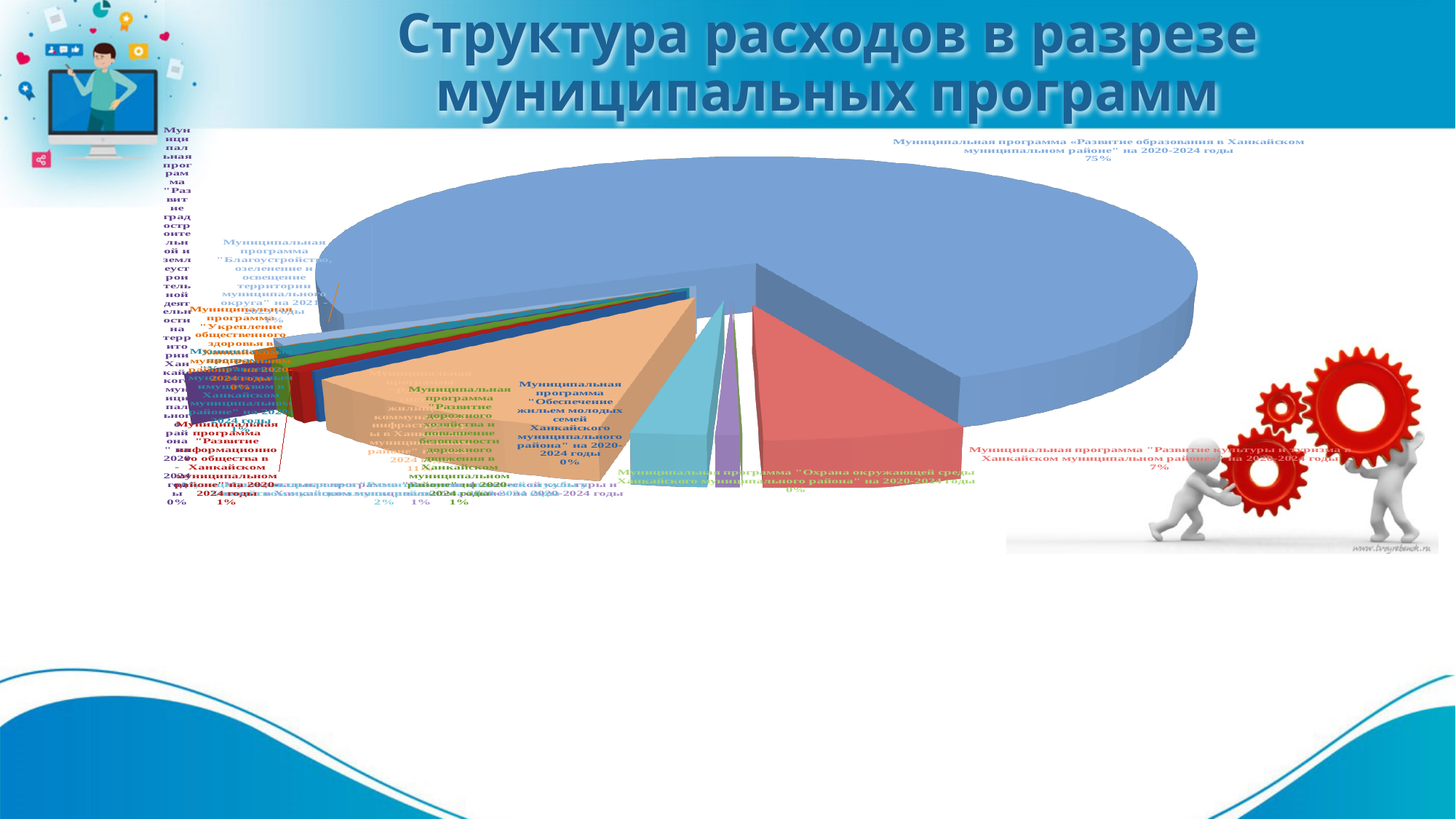
What share of expenditures goes to the program "Развитие культуры и туризма в Ханкайском муниципальном районе" на 2020-2024 годы? 7% By how many percentage points does the education program's share (75%) exceed the culture and tourism program's share (7%)? 68 percentage points What colour is the slice for the education program («Развитие образования»)? blue Which has a larger share: the education program («Развитие образования») or the culture and tourism program («Развитие культуры и туризма»)? Муниципальная программа «Развитие образования в Ханкайском муниципальном районе» на 2020-2024 годы What percentage is shown for the program "Обеспечение жильем молодых семей Ханкайского муниципального района" на 2020-2024 годы? 0% Which municipal program has the largest share of expenditures in the pie chart? Муниципальная программа «Развитие образования в Ханкайском муниципальном районе» на 2020-2024 годы What share of expenditures goes to the program «Развитие образования в Ханкайском муниципальном районе» на 2020-2024 годы? 75% What is the title of the slide's chart? Структура расходов в разрезе муниципальных программ What kind of chart is shown on the slide? pie chart What percentage is shown for the program "Охрана окружающей среды Ханкайского муниципального района" на 2020-2024 годы? 0%